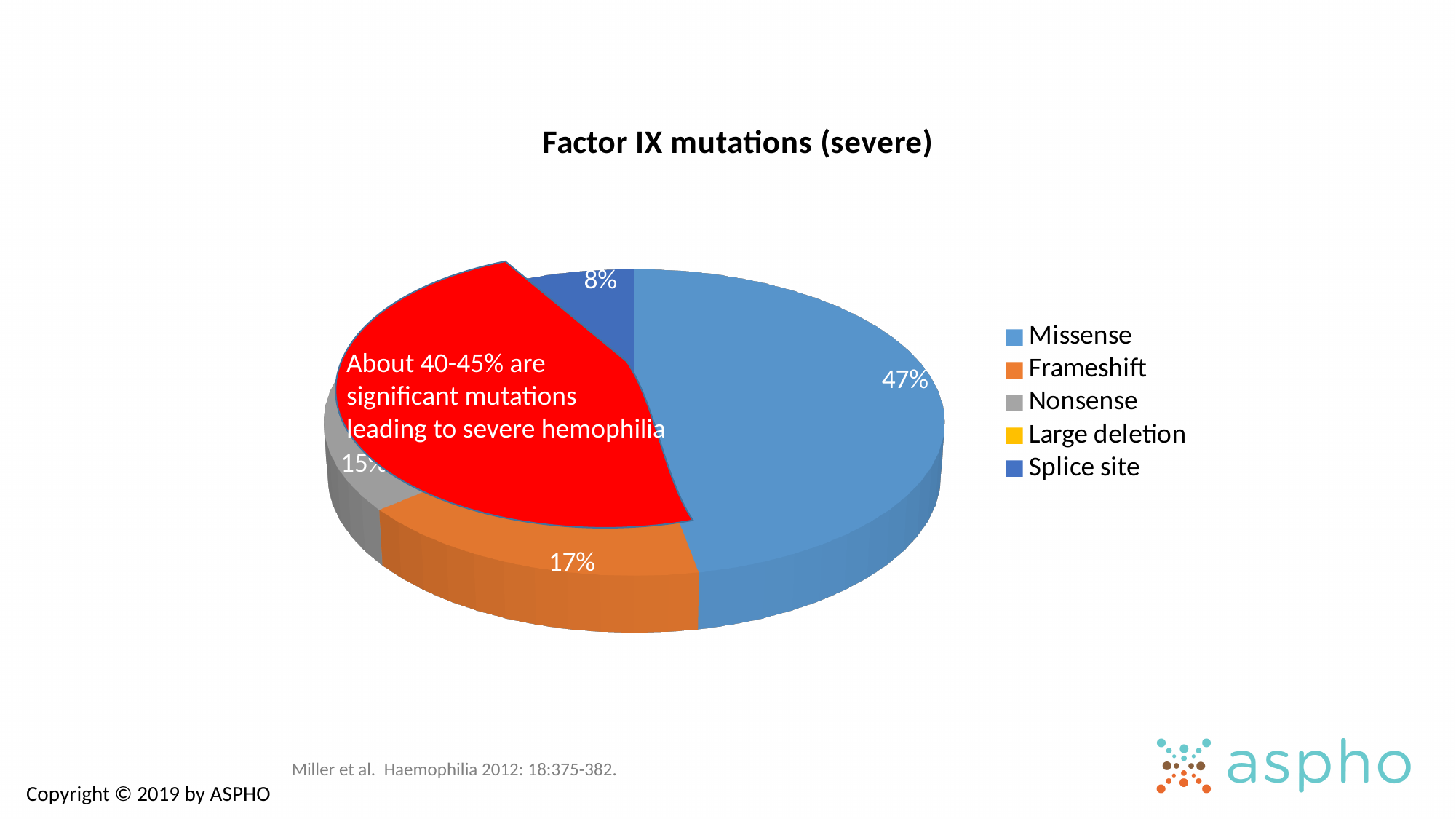
What percentage of the pie is Frameshift? 17% Which category has the largest share of the pie? Missense What is the difference in percentage points between the Frameshift share and the Splice site share? 9 What kind of chart is shown on the slide? pie chart Which legend entry is shown in orange? Frameshift Which is larger, the Missense share or the Frameshift share? Missense What is the title of the chart? Factor IX mutations (severe) What percentage of the pie is Missense? 47% How many categories does the legend list? 5 What is the difference in percentage points between the Missense share and the Frameshift share? 30 What percentage of the pie is Splice site? 8% Is the Missense share greater or less than 40%? greater